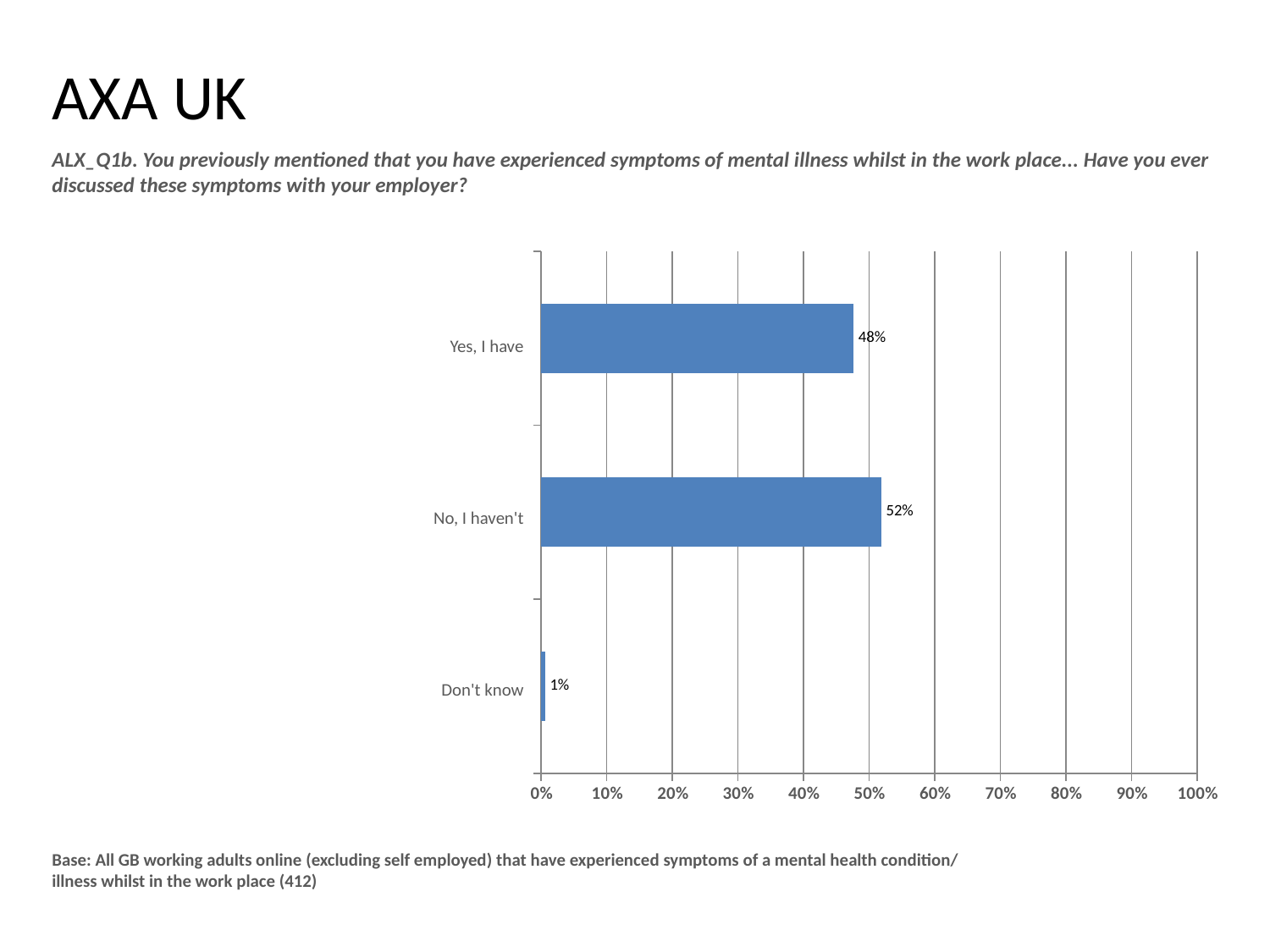
Is the value for "No, I haven't" greater or less than 50%? greater How many response categories are shown in the chart? 3 What percentage of respondents answered "Don't know"? 1% What is the maximum value shown on the horizontal axis? 100% Which response category has the lowest value? Don't know What percentage of respondents answered "Yes, I have"? 48% Is the value for "Yes, I have" greater or less than 50%? less What percentage of respondents answered "No, I haven't"? 52% Which response category has the highest value? No, I haven't What kind of chart is shown on the slide? Bar chart Which is larger, the value for "Yes, I have" or the value for "Don't know"? Yes, I have What is the difference between the "No, I haven't" and "Yes, I have" values? 4%